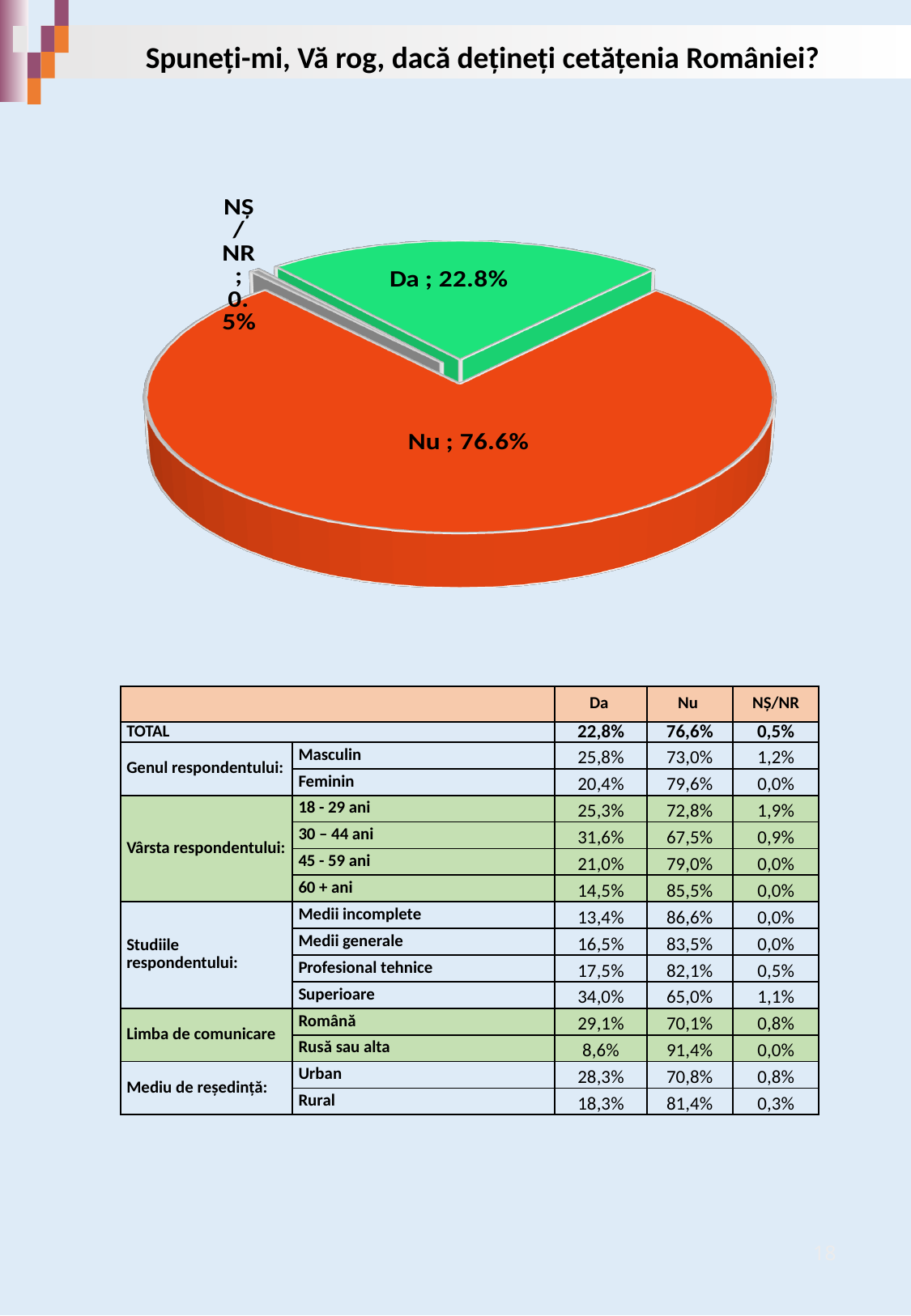
How many slices does the pie chart have? 3 What is the difference between the "Nu" and "Da" values in the pie chart? 53.8% What is the value shown for the "Da" slice of the pie chart? 22.8% Which is larger in the pie chart, "Da" or "Nu"? Nu What is the value shown for the "Nu" slice of the pie chart? 76.6% What colour is the "Da" slice of the pie chart? green What colour is the "Nu" slice of the pie chart? red-orange What is the value shown for the "NȘ/NR" slice of the pie chart? 0.5% What share of the pie does the "Da" slice represent? 22.8% Which slice of the pie chart is the largest? Nu Which slice of the pie chart is the smallest? NȘ/NR What kind of chart is shown on the slide? pie chart